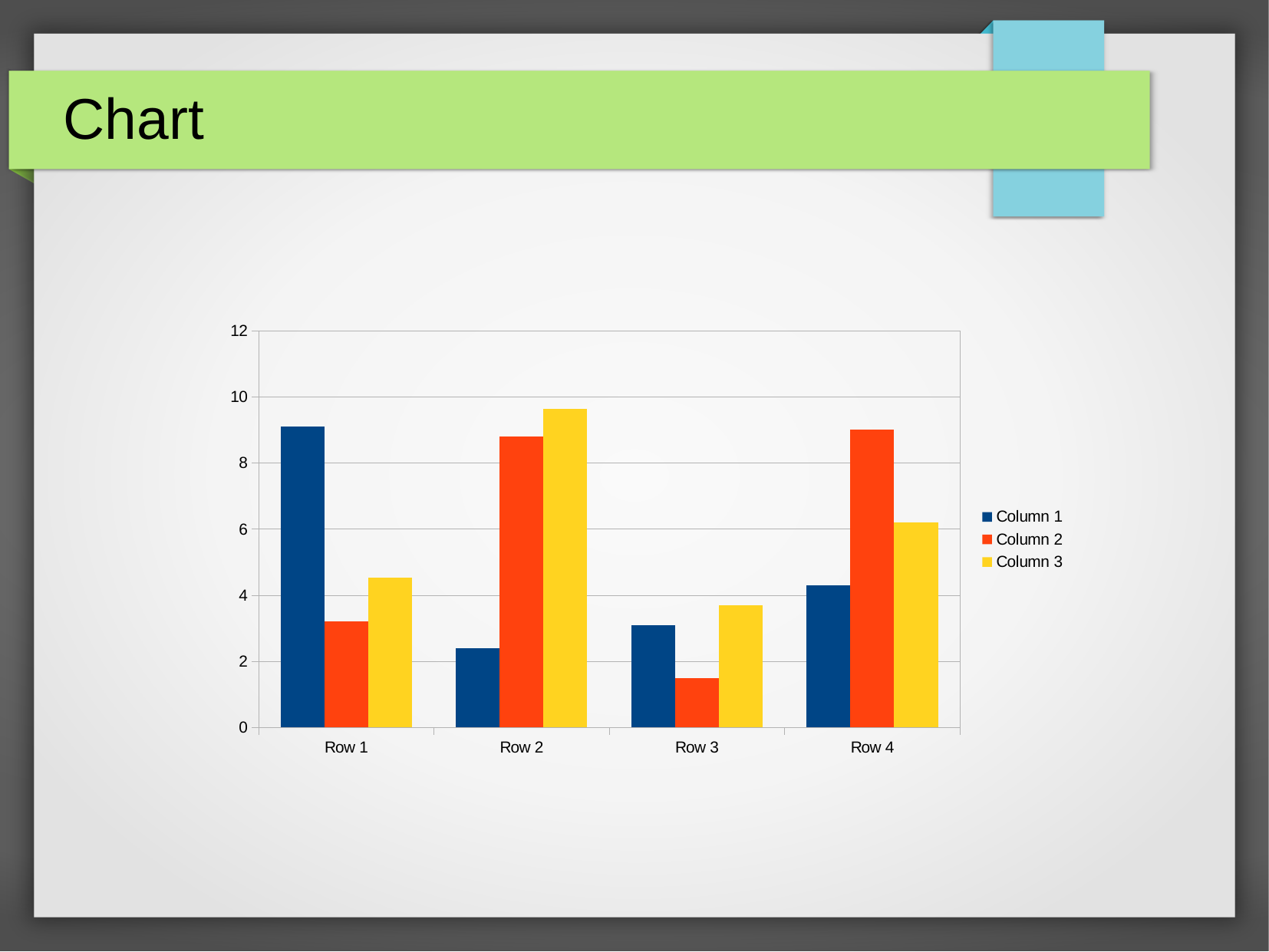
Which category has the highest value for Column 3? Row 2 Is the value for Column 1 in Row 2 greater or less than 4? less Is the value for Column 2 in Row 3 greater or less than 2? less Is the value for Column 1 in Row 1 greater or less than 8? greater In Row 4, which is larger: Column 2 or Column 3? Column 2 Which category has the highest value for Column 1? Row 1 What colour are the bars for Column 3? yellow Which category has the lowest value for Column 2? Row 3 What kind of chart is shown on the slide? bar chart How many series does the legend list? 3 How many categories are shown on the x axis? 4